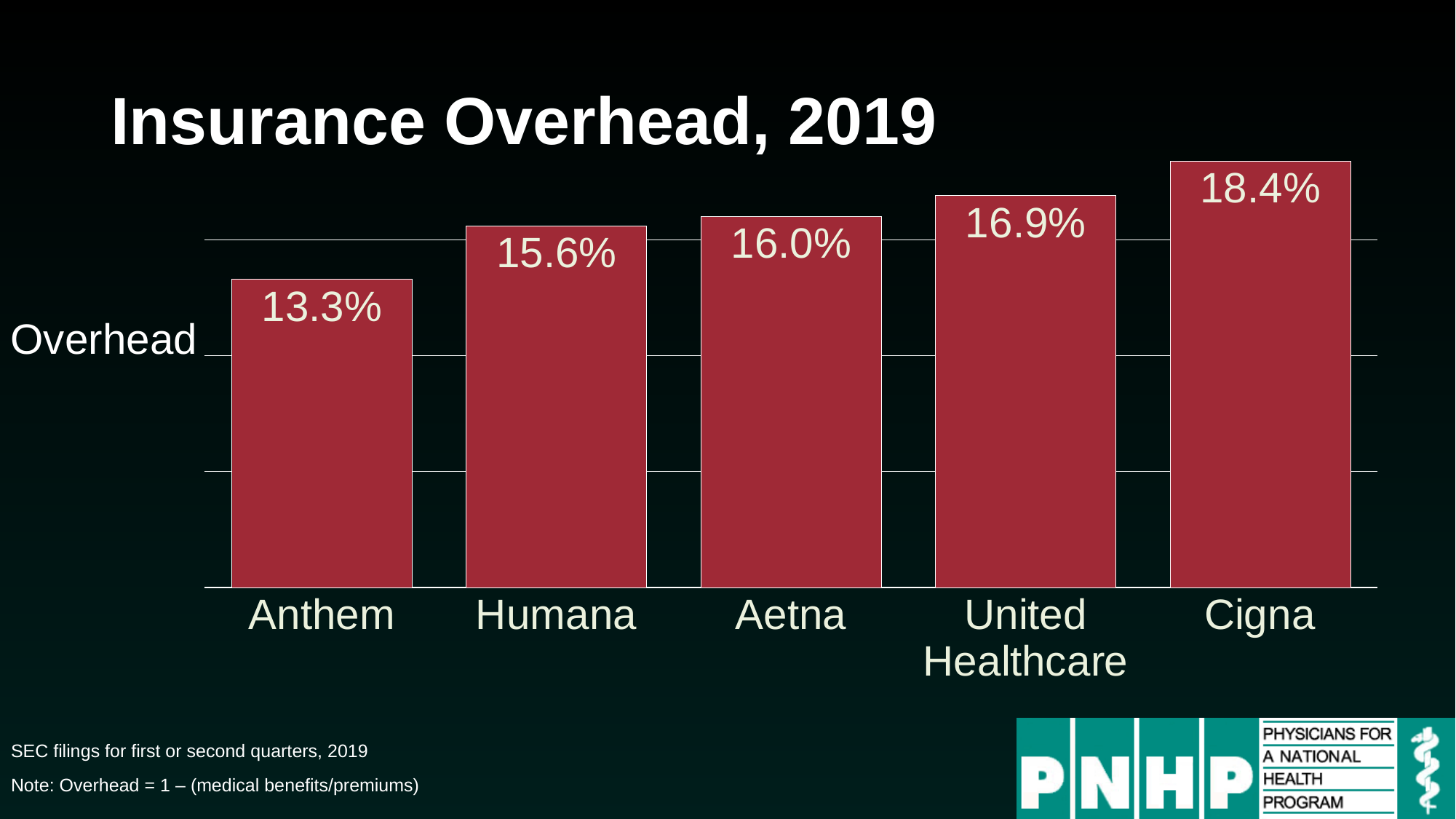
What is the overhead value for Humana? 15.6% Which has a higher overhead, Humana or United Healthcare? United Healthcare What is the overhead value for Anthem? 13.3% How many insurers are shown in the chart? 5 Which insurer has the highest overhead? Cigna What is the overhead value for Cigna? 18.4% What is the difference in overhead between Cigna and Anthem? 5.1% Which insurer has the lowest overhead? Anthem What is the title of the chart? Insurance Overhead, 2019 What is the overhead value for Aetna? 16.0% What is the overhead value for United Healthcare? 16.9% What kind of chart is shown on the slide? Bar chart